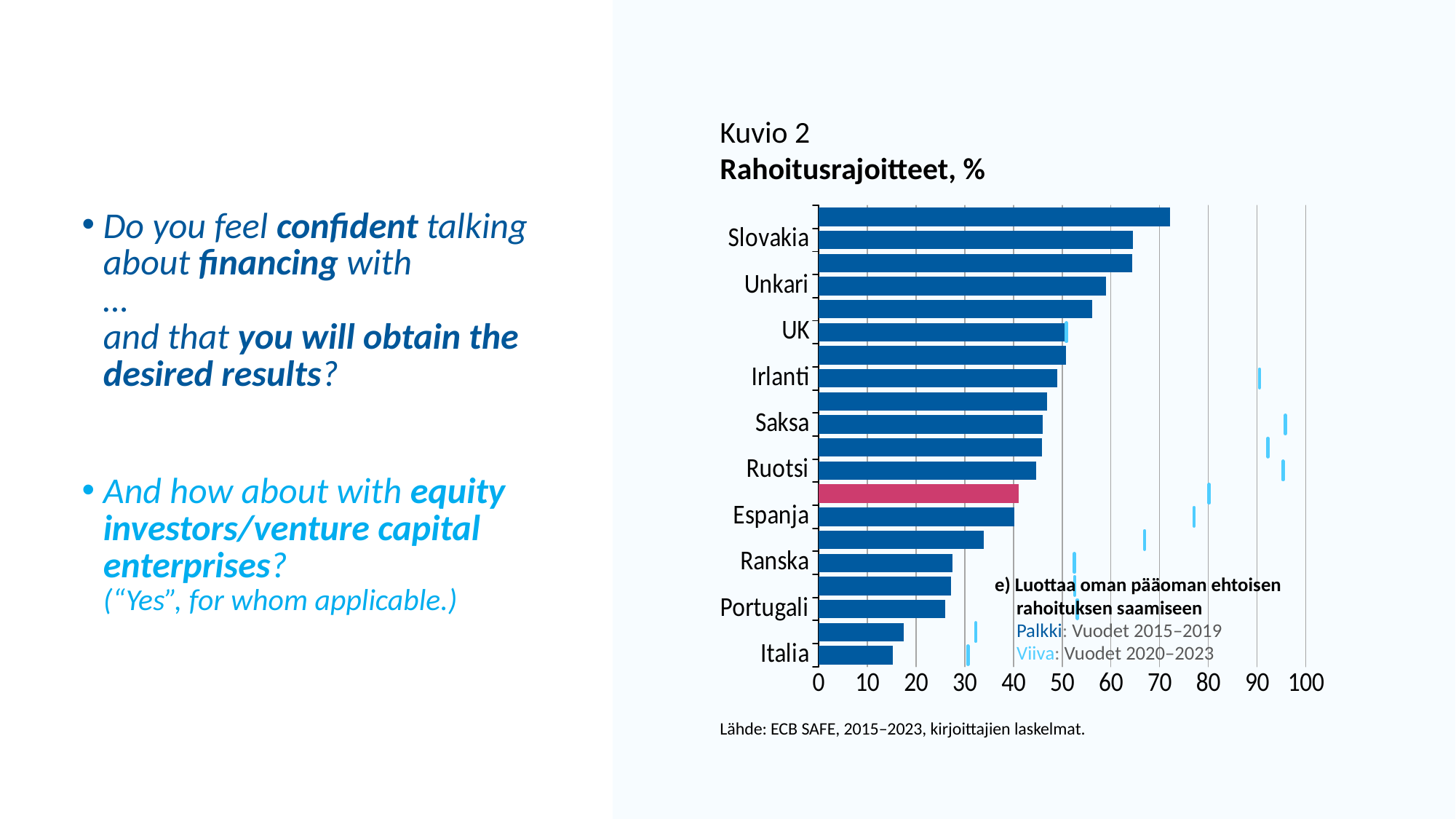
Which has the larger bar value, Slovakia or Italia? Slovakia According to the legend, which years does the line (Viiva) represent? Vuodet 2020–2023 What kind of chart is shown on the slide? bar chart Is the bar value for Slovakia greater or less than 60? greater Among the labeled countries, which has the lowest bar value? Italia Is the bar value for Espanja greater or less than 50? less Is the bar value for Ranska greater or less than 30? less Do the bar values rise or fall going from the top of the chart to the bottom? fall What is the title of the chart? Rahoitusrajoitteet, % How many series does the chart legend list? 2